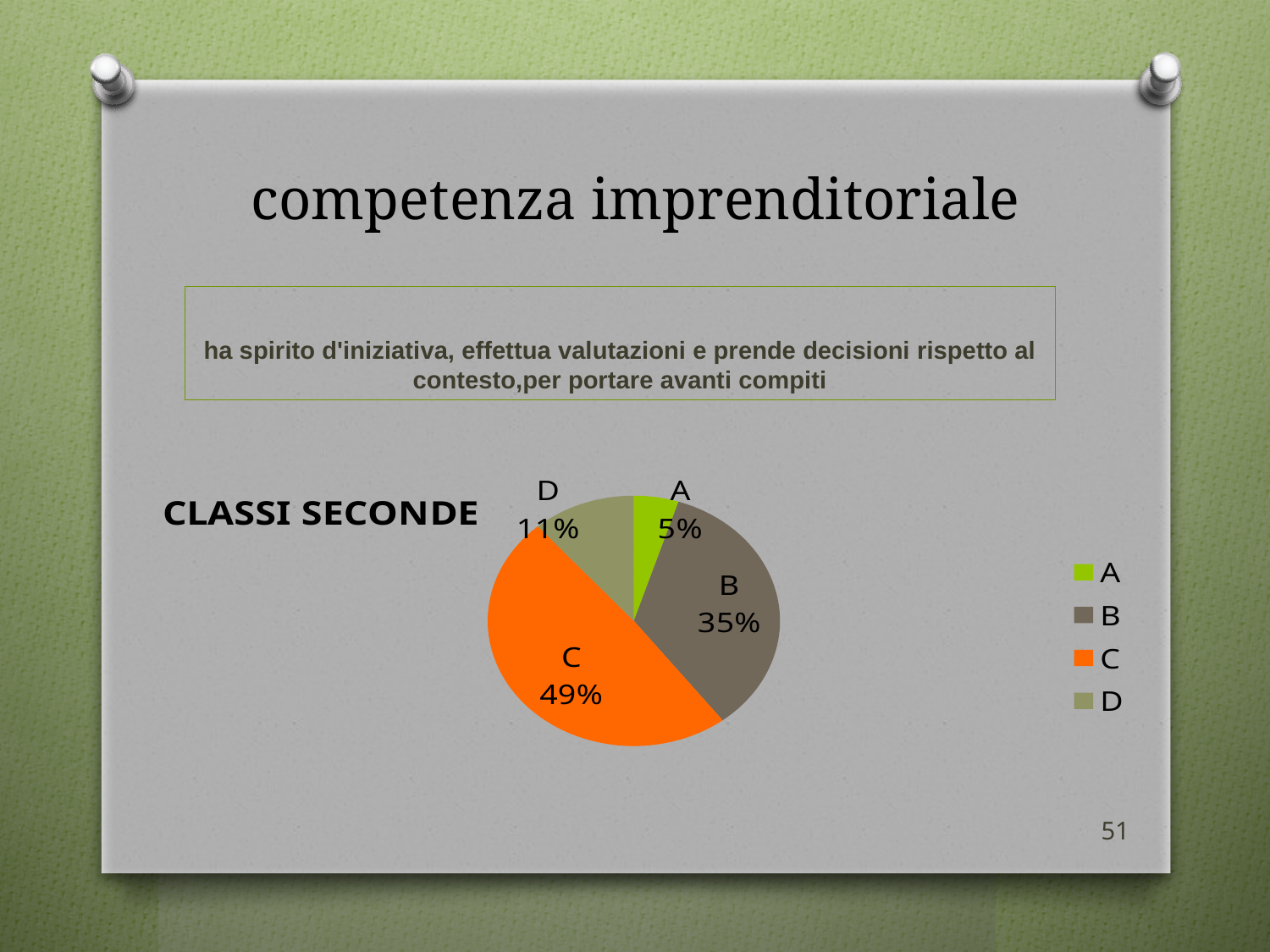
Which is larger, slice B or slice D? B What percentage does slice A represent in the pie chart? 5% Which slice of the pie chart is the smallest? A What kind of chart is shown on the slide? pie chart What percentage does slice D represent in the pie chart? 11% What percentage does slice B represent in the pie chart? 35% How many entries does the legend list? 4 What is the difference in percentage points between slice C and slice B? 14 What colour is slice C in the pie chart? orange What percentage does slice C represent in the pie chart? 49% Which slice of the pie chart is the largest? C How many slices does the pie chart have? 4